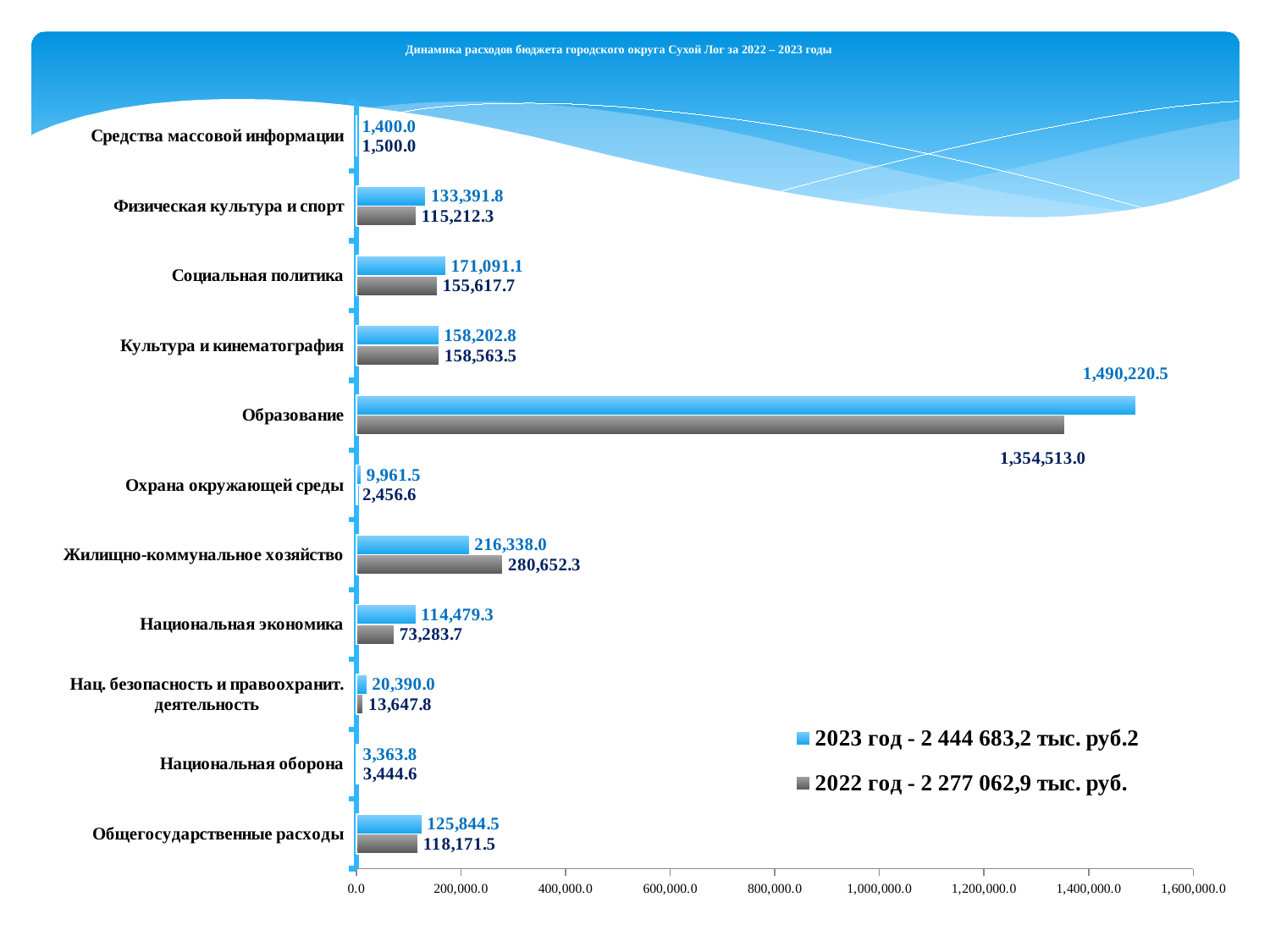
What is the difference between the 2023 and 2022 values for Образование? 135,707.5 Which is larger for Жилищно-коммунальное хозяйство: the 2023 value or the 2022 value? 2022 value How many categories are shown on the chart? 11 How many series does the legend list? 2 What is the 2023 value for Охрана окружающей среды? 9,961.5 What type of chart is shown on the slide? Bar chart What is the 2023 value for Образование? 1,490,220.5 Which category has the lowest 2023 value? Средства массовой информации What is the 2022 value for Жилищно-коммунальное хозяйство? 280,652.3 What colour are the bars for the 2022 series? Grey Which category has the highest 2023 value? Образование Is the 2023 value for Социальная политика greater or less than 200,000.0? less